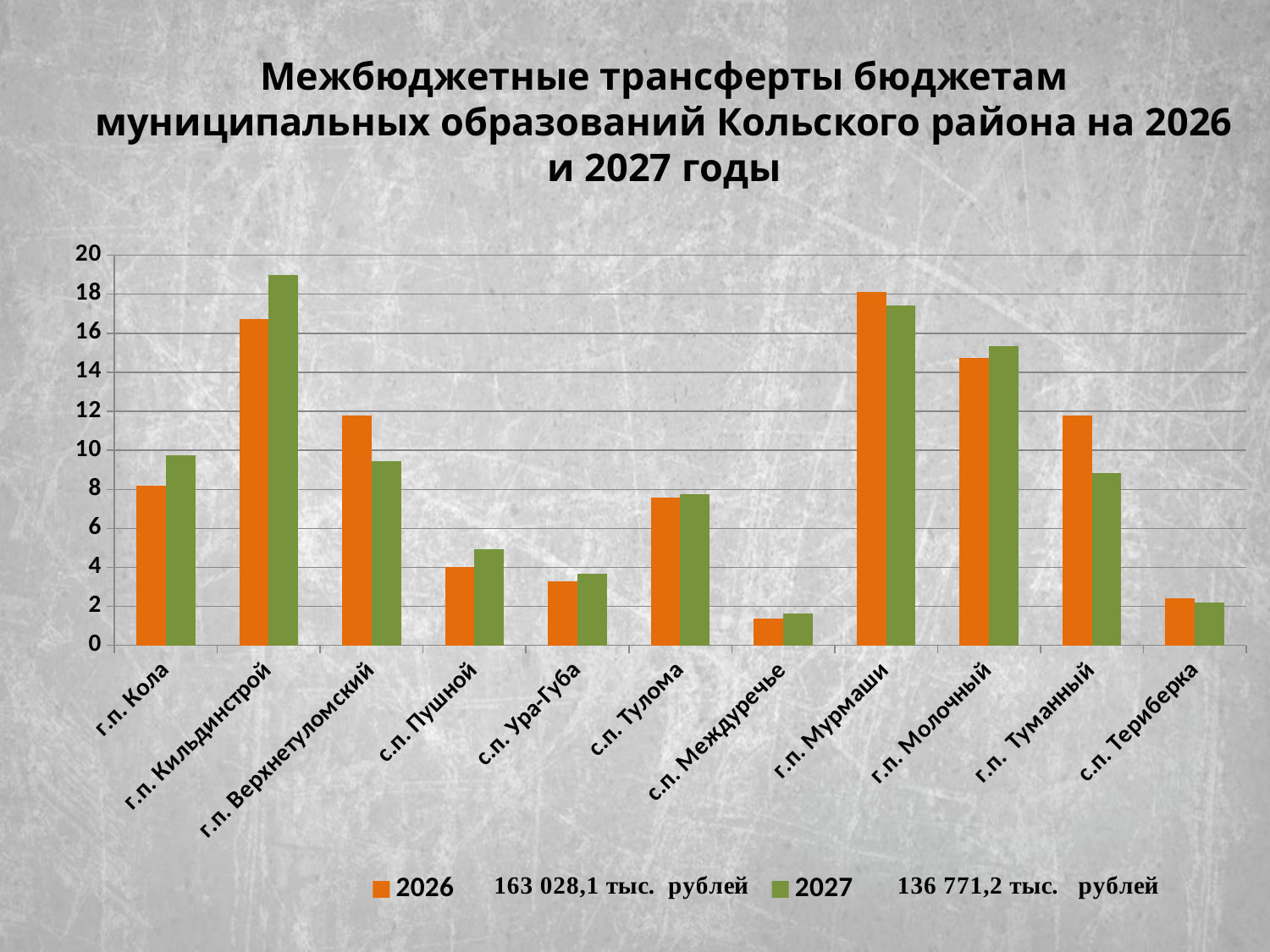
Which municipality has the highest value for 2026? г.п. Мурмаши Which municipality has the lowest value for 2026? с.п. Междуречье How many municipalities (categories) are shown on the x axis? 11 How many series does the legend list? 2 For г.п. Верхнетуломский, which year has the larger value, 2026 or 2027? 2026 What total amount is shown next to the 2026 legend entry? 163 028,1 тыс. рублей Which municipality has the highest value for 2027? г.п. Кильдинстрой What kind of chart is shown on the slide? bar chart Is the 2027 value for г.п. Кола greater or less than 8? greater For г.п. Кола, which year has the larger value, 2026 or 2027? 2027 Is the 2026 value for г.п. Верхнетуломский greater or less than 10? greater Is the 2027 value for г.п. Туманный greater or less than 10? less